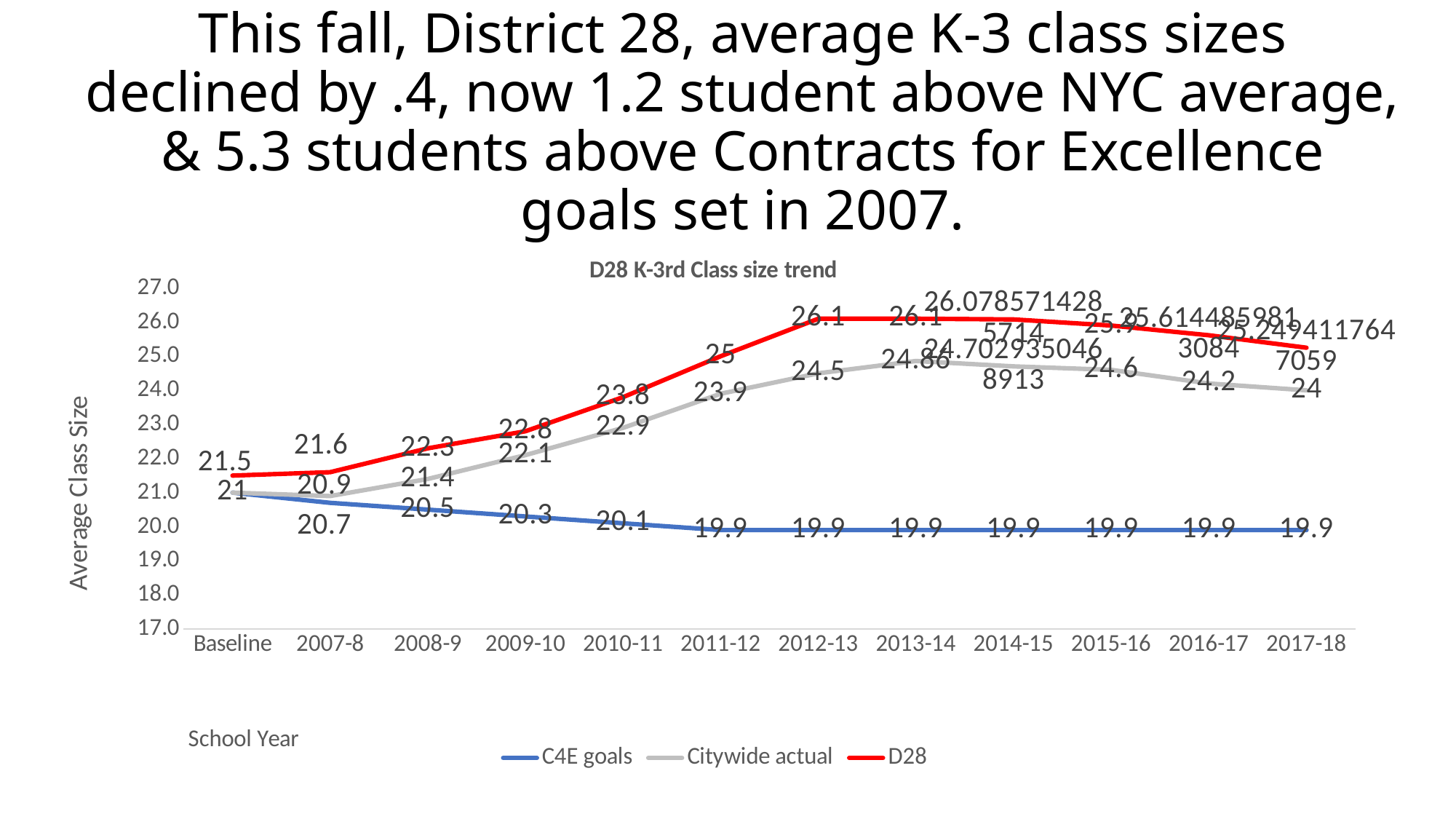
What is the Citywide actual value for 2011-12? 23.9 How many school-year categories are shown on the x axis? 12 In 2011-12, how much higher is the D28 value than the Citywide actual value? 1.1 What is the D28 value for 2012-13? 26.1 What is the Citywide actual value for 2016-17? 24.2 Do the C4E goals values rise or fall from Baseline to 2011-12? fall What is the D28 value at Baseline? 21.5 In 2010-11, which is larger: the D28 value or the Citywide actual value? D28 How many series does the legend list? 3 What is the C4E goals value for 2017-18? 19.9 What is the title of the chart? D28 K-3rd Class size trend What kind of chart is shown on the slide? line chart